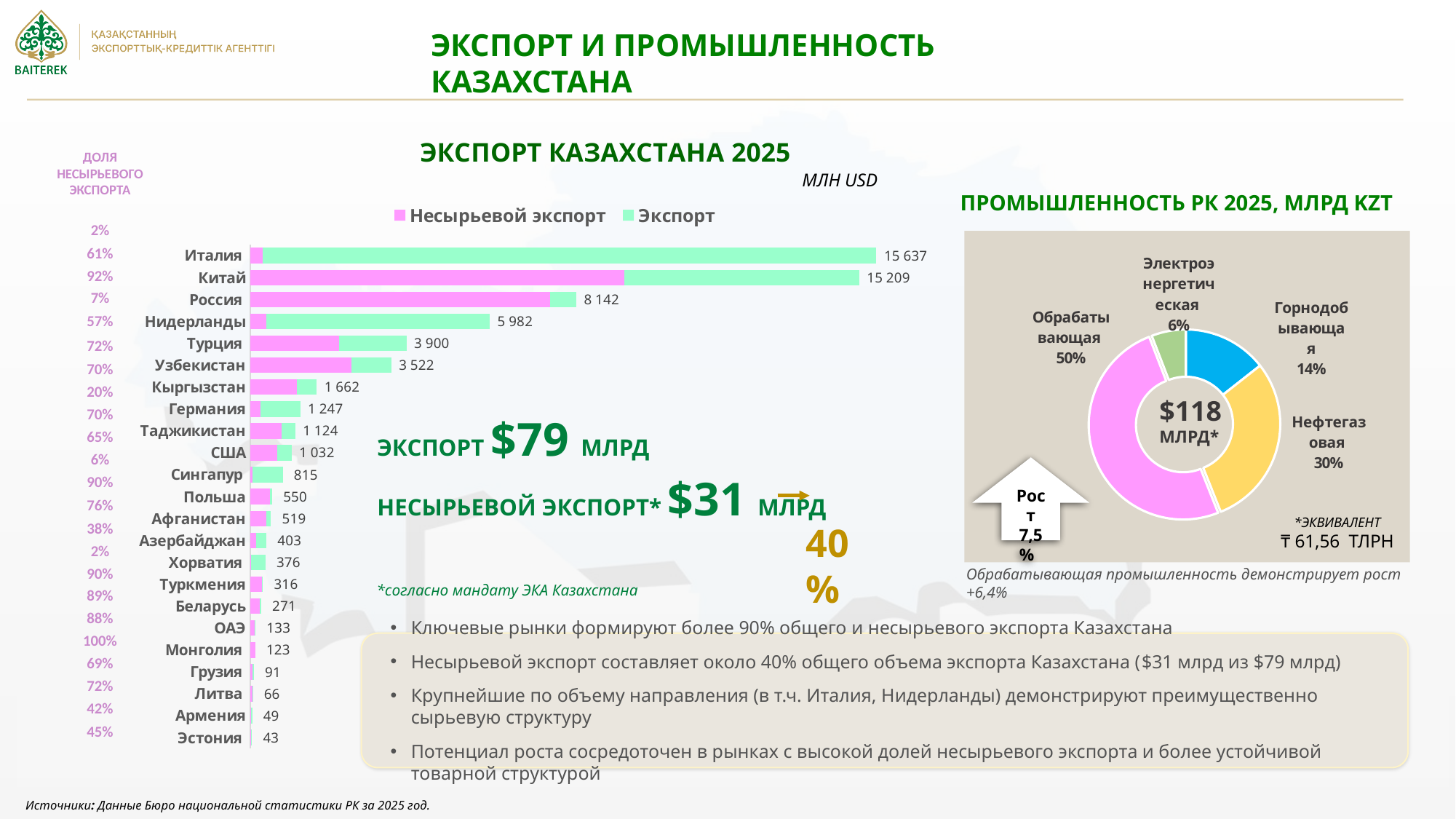
In the bar chart 'ЭКСПОРТ КАЗАХСТАНА 2025', what is the difference between the labelled values for Италия and Китай? 428 In the bar chart 'ЭКСПОРТ КАЗАХСТАНА 2025', which country has the highest labelled export value? Италия In the bar chart 'ЭКСПОРТ КАЗАХСТАНА 2025', which country has the lowest labelled export value? Эстония In the bar chart 'ЭКСПОРТ КАЗАХСТАНА 2025', which has the larger labelled export value, Россия or Нидерланды? Россия In the bar chart 'ЭКСПОРТ КАЗАХСТАНА 2025', what is the export value labelled for Китай? 15 209 In the donut chart 'ПРОМЫШЛЕННОСТЬ РК 2025, МЛРД KZT', what share does Обрабатывающая have? 50% How many countries are listed in the bar chart 'ЭКСПОРТ КАЗАХСТАНА 2025'? 23 What kind of chart is 'ЭКСПОРТ КАЗАХСТАНА 2025'? Bar chart In the bar chart 'ЭКСПОРТ КАЗАХСТАНА 2025', what is the export value labelled for Италия? 15 637 In the donut chart 'ПРОМЫШЛЕННОСТЬ РК 2025, МЛРД KZT', how many sectors are shown? 4 In the donut chart 'ПРОМЫШЛЕННОСТЬ РК 2025, МЛРД KZT', which sector has the smallest share? Электроэнергетическая How many series does the legend of the bar chart 'ЭКСПОРТ КАЗАХСТАНА 2025' list? 2